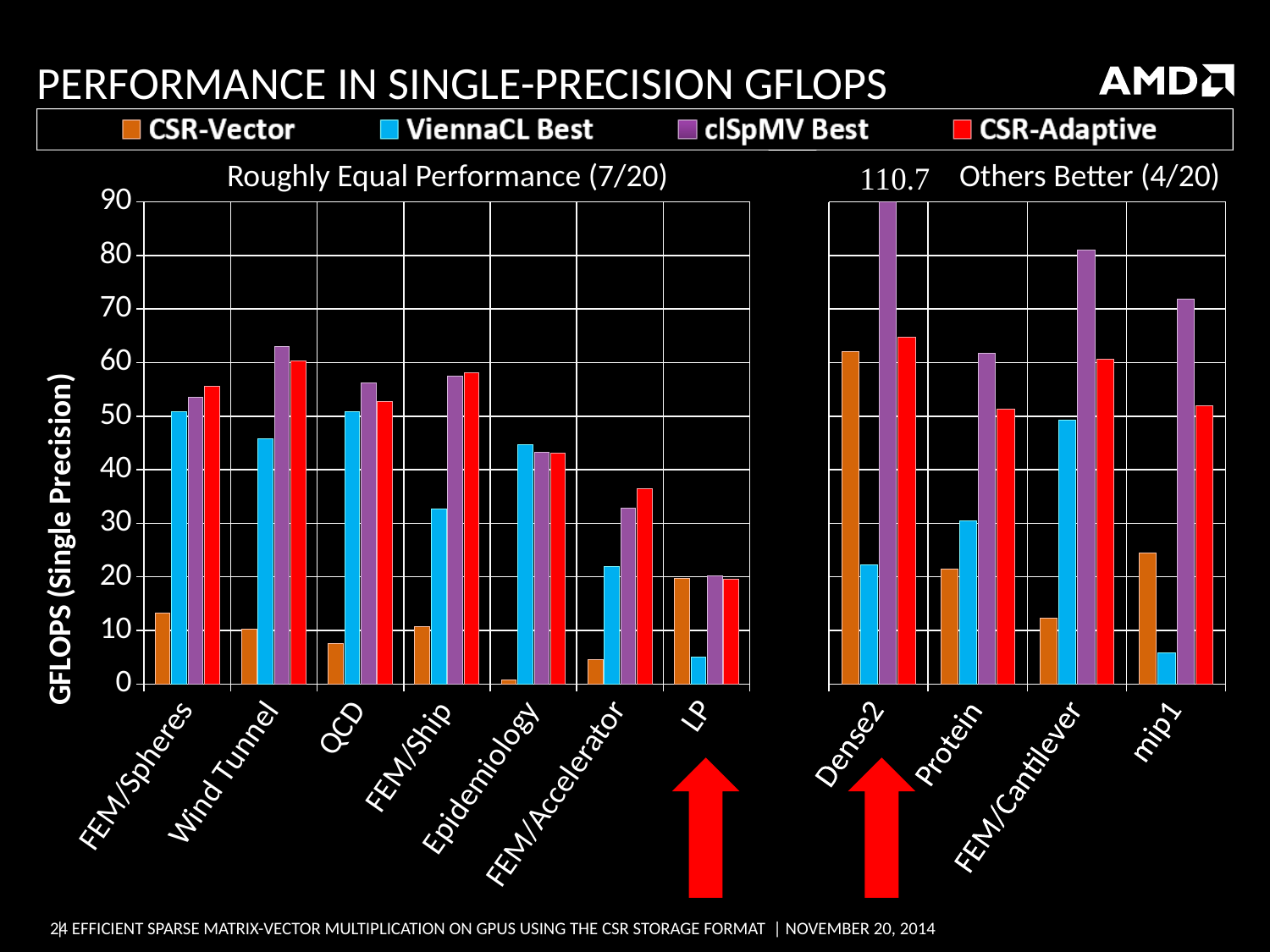
In the 'Roughly Equal Performance (7/20)' chart, which category has the lowest CSR-Vector value? Epidemiology What kind of chart is used on this slide? bar chart How many series does the legend list? 4 In the 'Others Better (4/20)' chart, is the clSpMV Best value for FEM/Cantilever greater or less than 70? greater In the 'Roughly Equal Performance (7/20)' chart, is the CSR-Vector value for Wind Tunnel greater or less than 20? less In the 'Roughly Equal Performance (7/20)' chart, how many categories are shown on the x axis? 7 In the 'Roughly Equal Performance (7/20)' chart, is the ViennaCL Best value for FEM/Spheres greater or less than 40? greater In the 'Roughly Equal Performance (7/20)' chart, for FEM/Ship, which is larger: ViennaCL Best or clSpMV Best? clSpMV Best In the 'Others Better (4/20)' chart, for Protein, which is larger: CSR-Vector or ViennaCL Best? ViennaCL Best In the 'Others Better (4/20)' chart, which category has the highest clSpMV Best value? Dense2 In the 'Others Better (4/20)' chart, how many categories are shown on the x axis? 4 In the 'Others Better (4/20)' chart, what is the clSpMV Best value for Dense2? 110.7